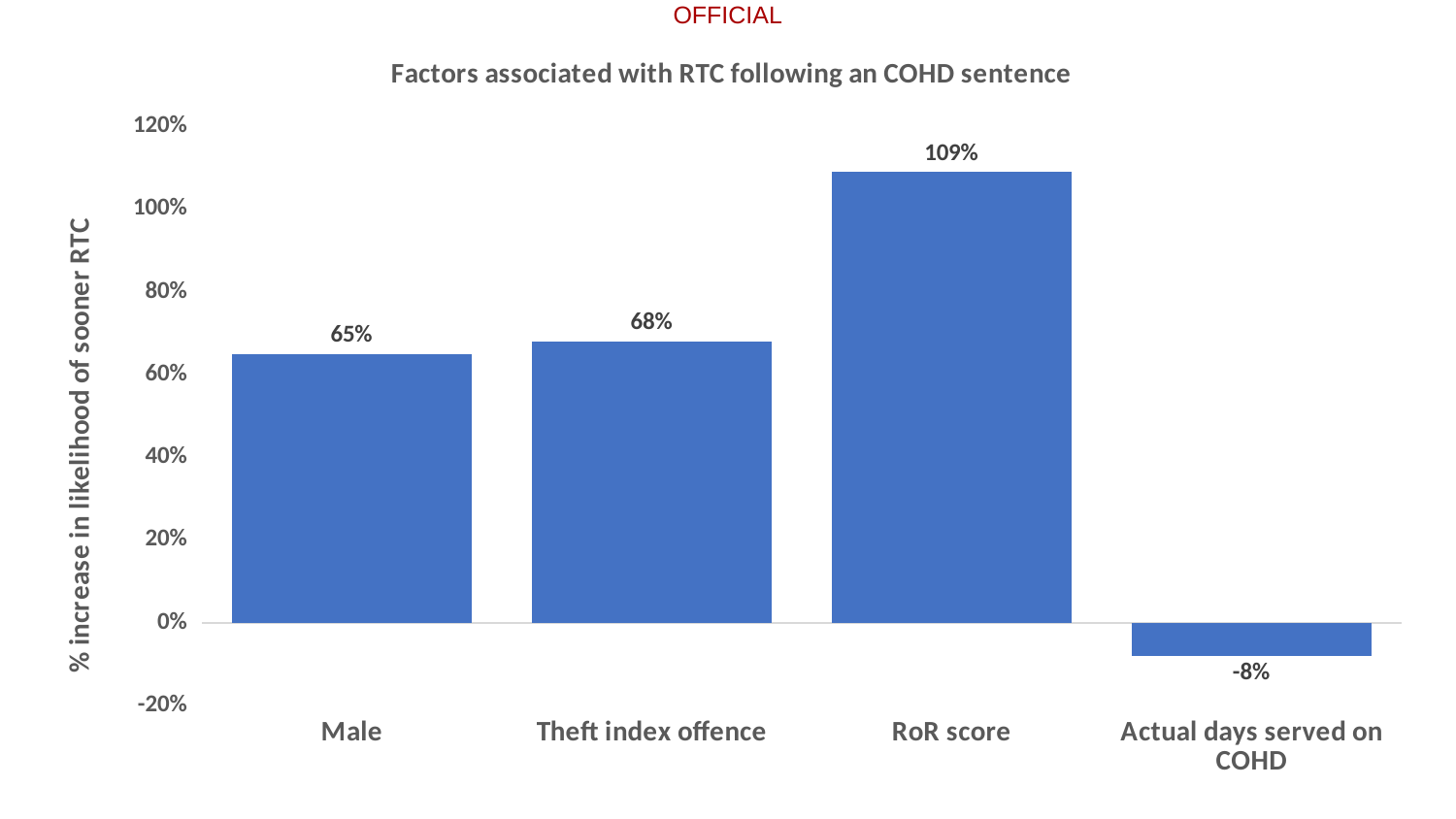
Which is larger, the value for Theft index offence or the value for Male? Theft index offence What is the value for Theft index offence? 68% Is the value for RoR score greater or less than 100%? greater What is the value for Actual days served on COHD? -8% Which category has the highest value? RoR score What kind of chart is shown? Bar chart What is the difference between the values for RoR score and Male? 44% What is the value for RoR score? 109% What is the title of the chart? Factors associated with RTC following an COHD sentence How many categories are shown on the x axis? 4 Which category has the lowest value? Actual days served on COHD What is the value for Male? 65%